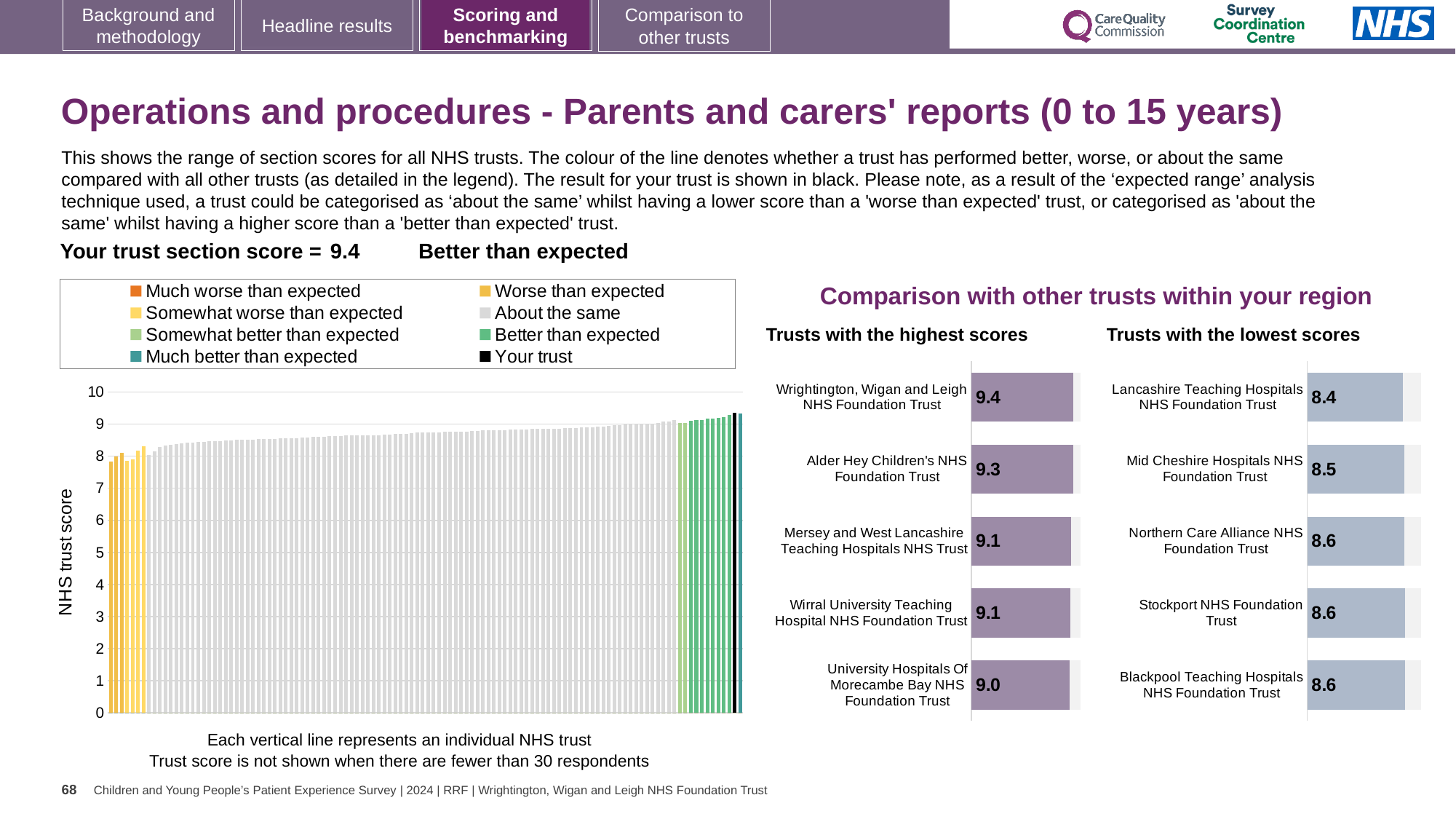
In the 'Trusts with the highest scores' chart, what is the difference between the scores of Wrightington, Wigan and Leigh NHS Foundation Trust and University Hospitals Of Morecambe Bay NHS Foundation Trust? 0.4 In the 'Trusts with the lowest scores' chart, what is the score for Mid Cheshire Hospitals NHS Foundation Trust? 8.5 How many trusts are shown in the 'Trusts with the highest scores' chart? 5 In the 'Trusts with the lowest scores' chart, what is the difference between the scores of Northern Care Alliance NHS Foundation Trust and Lancashire Teaching Hospitals NHS Foundation Trust? 0.2 In the large chart on the left, what is the section score for your trust (shown in black)? 9.4 In the 'Trusts with the highest scores' chart, which trust has the highest score? Wrightington, Wigan and Leigh NHS Foundation Trust In the 'Trusts with the highest scores' chart, what is the score for Alder Hey Children's NHS Foundation Trust? 9.3 How many entries does the legend of the large chart on the left list? 8 In the 'Trusts with the lowest scores' chart, which trust has the lowest score? Lancashire Teaching Hospitals NHS Foundation Trust In the 'Trusts with the lowest scores' chart, which has the larger score: Lancashire Teaching Hospitals NHS Foundation Trust or Stockport NHS Foundation Trust? Stockport NHS Foundation Trust What kind of chart is the large chart on the left showing NHS trust scores? bar chart In the large chart on the left, do the trust scores rise or fall from left to right? rise